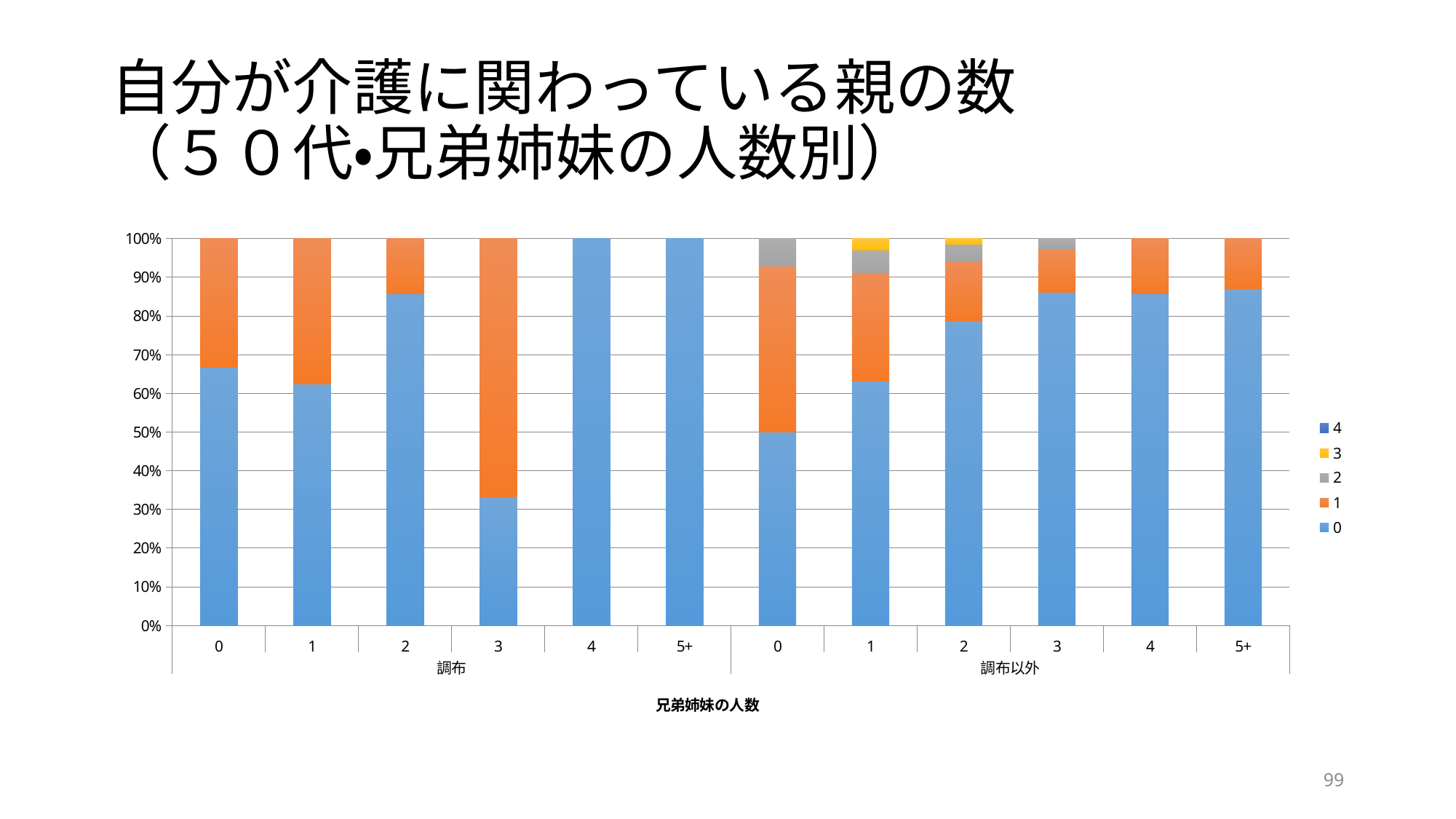
What kind of chart is shown on the slide? stacked bar chart How many series does the legend list? 5 For series 0, which is larger: category 0 in the 調布 group or category 3 in the 調布 group? category 0 in the 調布 group How many bars are plotted in the chart? 12 Is the value of series 0 for category 0 in the 調布 group greater or less than 60%? greater What are the two group labels shown along the x axis? 調布 and 調布以外 Is the value of series 0 for category 3 in the 調布 group greater or less than 40%? less What is the value of series 0 for category 4 in the 調布 group? 100% Is the value of series 0 for category 2 in the 調布以外 group greater or less than 70%? greater What is the x-axis title of the chart? 兄弟姉妹の人数 Which bar has the smallest share for series 0? 調布 3 What is the value of series 0 for category 5+ in the 調布 group? 100%